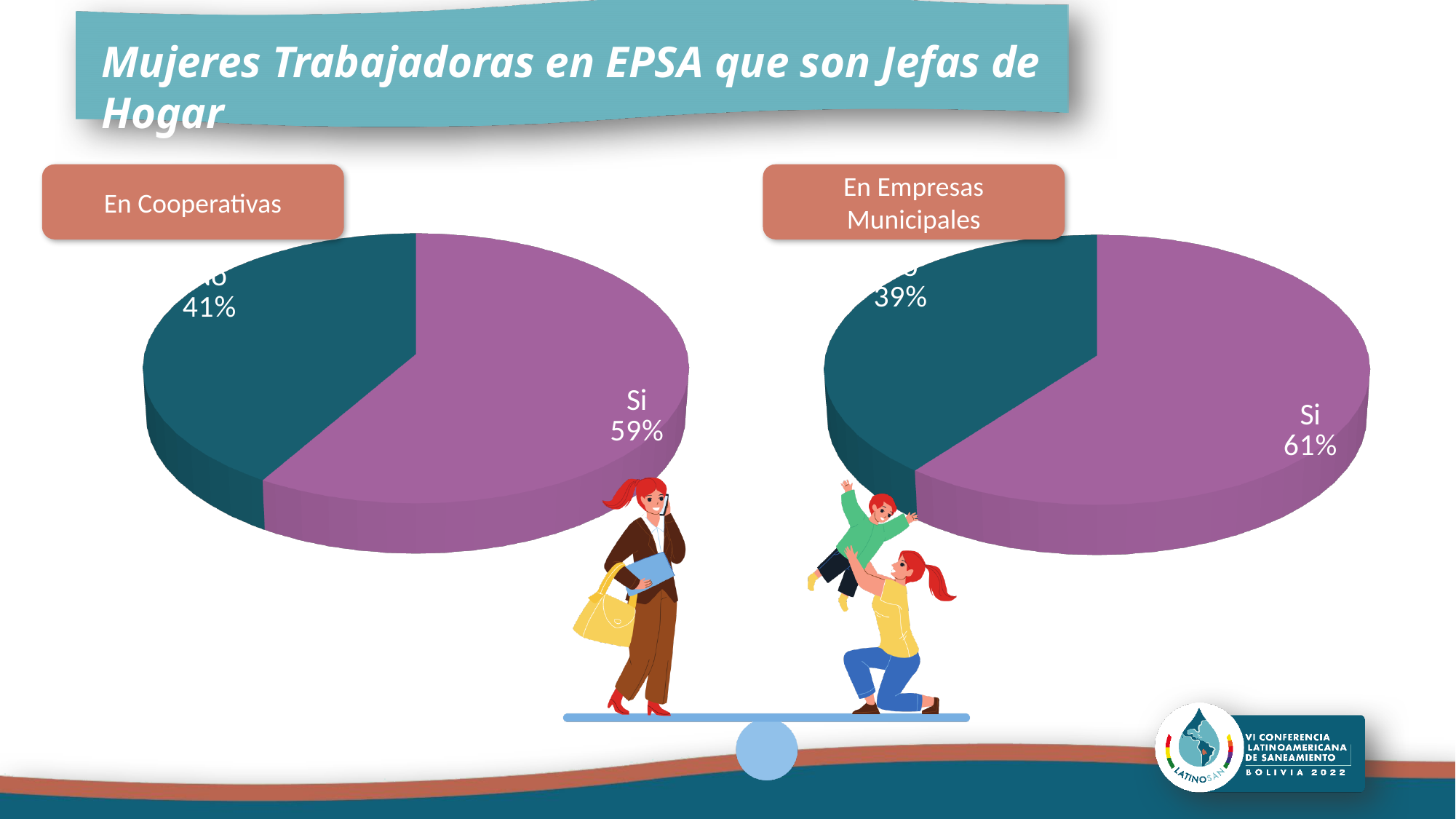
In the 'En Empresas Municipales' chart, what percentage is shown for the dark teal slice? 39% In the 'En Empresas Municipales' chart, which slice is the largest? Si What kind of chart is used under 'En Cooperativas'? Pie chart In the 'En Cooperativas' chart, what is the difference between the 'Si' slice and the dark teal slice? 18% In the 'En Cooperativas' chart, what percentage is shown for the dark teal slice? 41% In the 'En Empresas Municipales' chart, what percentage is shown for the 'Si' slice? 61% Is the 'Si' share larger in the 'En Cooperativas' chart or in the 'En Empresas Municipales' chart? En Empresas Municipales In the 'En Cooperativas' chart, what percentage is shown for the 'Si' slice? 59% How many pie charts are shown on the slide? 2 What is the difference between the 'Si' percentage in the 'En Empresas Municipales' chart and the 'Si' percentage in the 'En Cooperativas' chart? 2% In the 'En Cooperativas' chart, which slice is the largest? Si How many slices does the 'En Empresas Municipales' pie chart have? 2